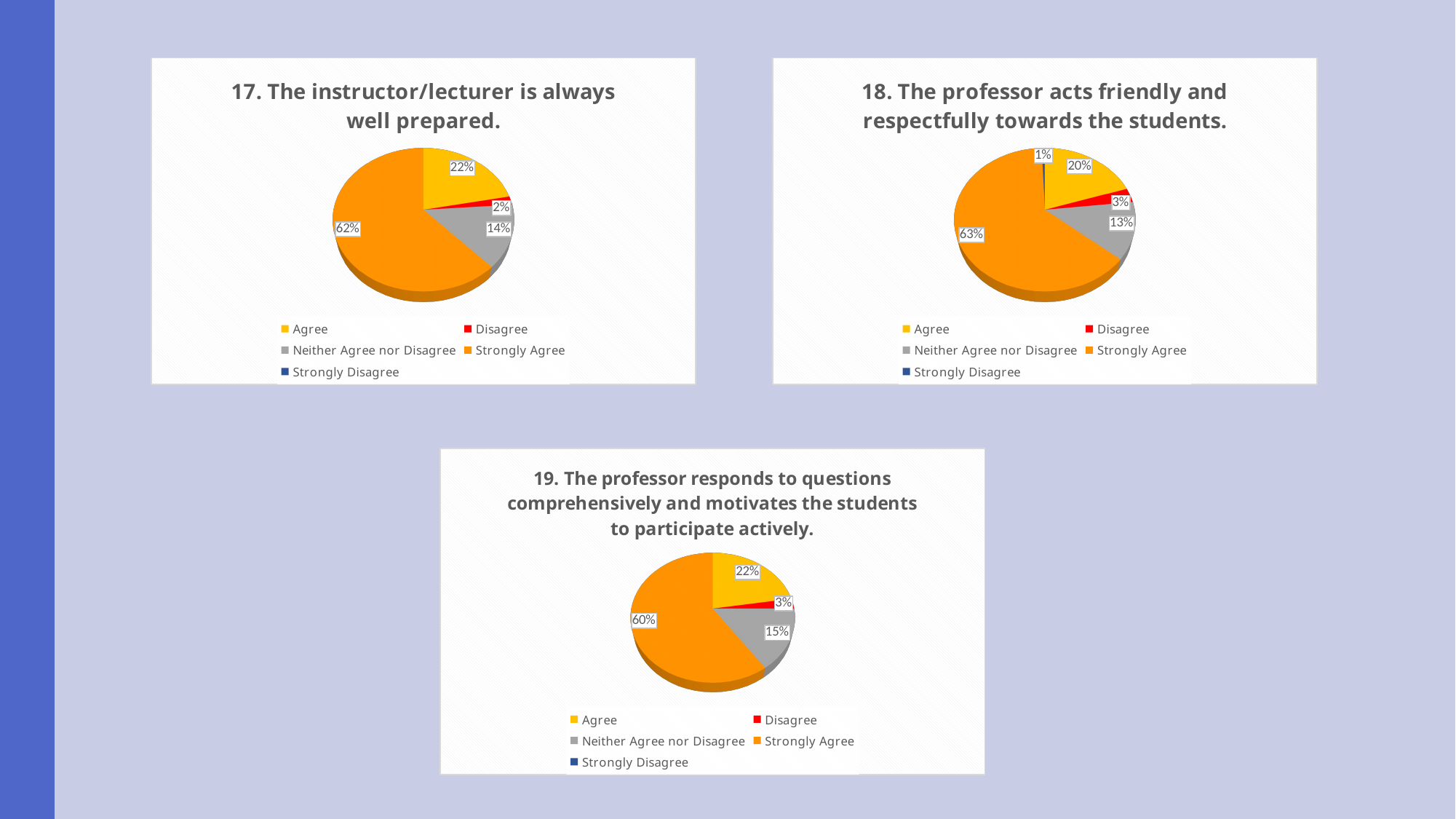
In the chart titled "18. The professor acts friendly and respectfully towards the students.", what percentage is shown for Strongly Disagree? 1% In the chart titled "17. The instructor/lecturer is always well prepared.", what percentage is shown for Neither Agree nor Disagree? 14% In the chart titled "19. The professor responds to questions comprehensively and motivates the students to participate actively.", what percentage is shown for Neither Agree nor Disagree? 15% In the chart titled "19. The professor responds to questions comprehensively and motivates the students to participate actively.", which is larger, the Agree slice or the Disagree slice? Agree What kind of chart is used for "17. The instructor/lecturer is always well prepared."? Pie chart In the chart titled "19. The professor responds to questions comprehensively and motivates the students to participate actively.", what percentage is shown for Strongly Agree? 60% How many entries does the legend list in the chart titled "18. The professor acts friendly and respectfully towards the students."? 5 In the chart titled "18. The professor acts friendly and respectfully towards the students.", what percentage is shown for Agree? 20% In the chart titled "17. The instructor/lecturer is always well prepared.", what percentage is shown for Strongly Agree? 62% In the chart titled "18. The professor acts friendly and respectfully towards the students.", what is the difference between the Strongly Agree and Agree percentages? 43% In the chart titled "17. The instructor/lecturer is always well prepared.", what colour represents Disagree in the legend? Red In the chart titled "17. The instructor/lecturer is always well prepared.", which response has the largest slice? Strongly Agree